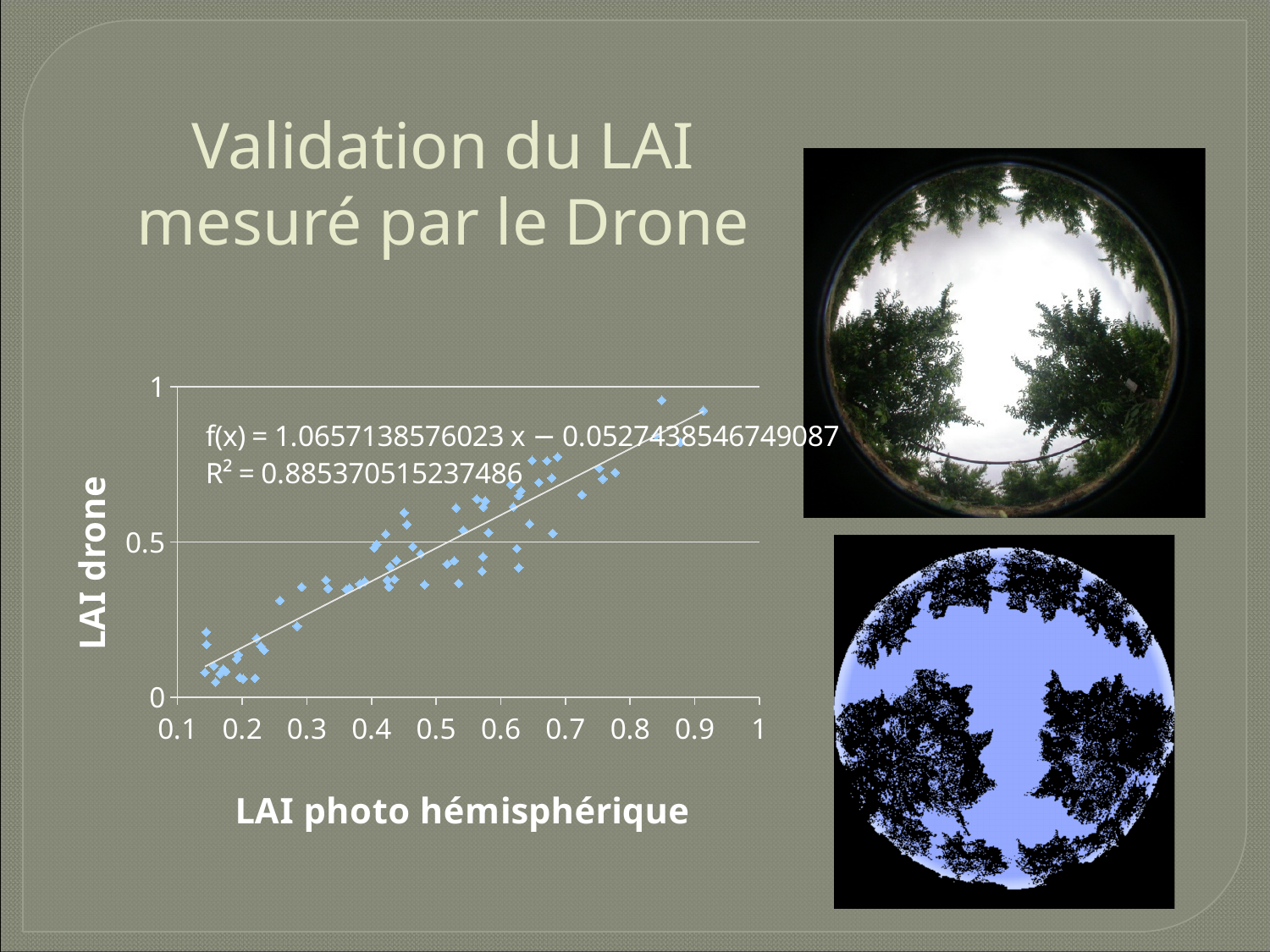
What is the title of the x axis of the chart? LAI photo hémisphérique Do the LAI drone values rise or fall as LAI photo hémisphérique increases along the x axis? rise Is the LAI drone value for the point near LAI photo hémisphérique 0.85 greater or less than 0.5? greater What is the title of the y axis of the chart? LAI drone What is the trendline equation printed on the chart? f(x) = 1.0657138576023 x − 0.0527438546749087 Are the LAI drone values for points near LAI photo hémisphérique 0.15 greater or less than 0.5? less What kind of chart is shown on the slide? scatter chart What is the R² value printed on the chart? R² = 0.885370515237486 What is the highest tick value shown on the y axis of the chart? 1